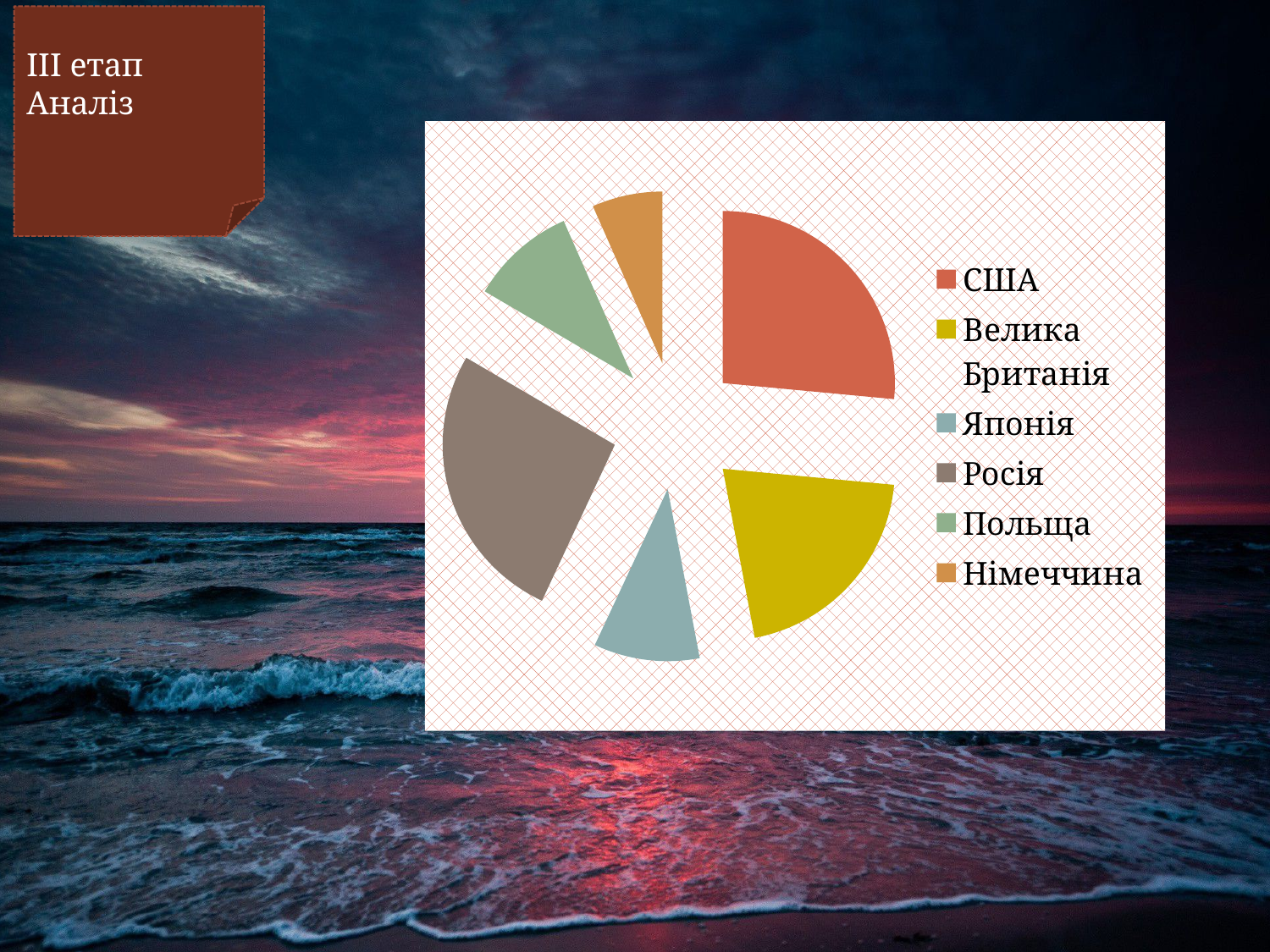
Which slice is larger, Велика Британія or Японія? Велика Британія What colour is the slice for США in the pie chart? red Which category has the smallest slice in the pie chart? Німеччина Which slice is larger, США or Німеччина? США Which slice is larger, США or Велика Британія? США Which category is listed last in the chart legend? Німеччина What kind of chart is shown on the slide? pie chart How many slices does the pie chart have? 6